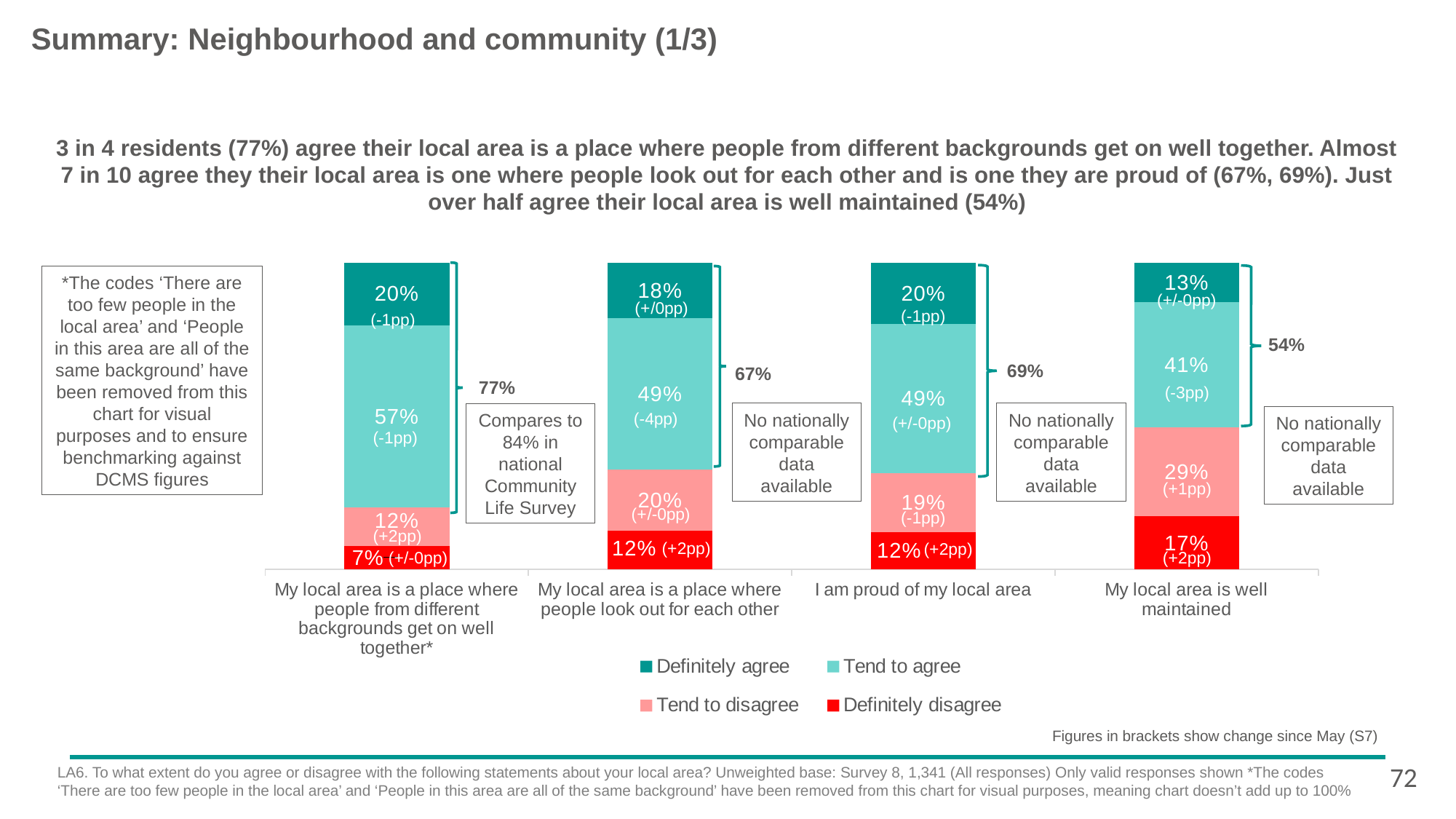
What is the 'Tend to agree' value for 'My local area is a place where people from different backgrounds get on well together*'? 57% What is the combined agree total (Definitely agree plus Tend to agree) shown for 'I am proud of my local area'? 69% What is the 'Definitely agree' value for 'My local area is a place where people look out for each other'? 18% Which statement has the lowest 'Definitely agree' value? My local area is well maintained Which is larger: the 'Definitely disagree' value for 'I am proud of my local area' or for 'My local area is well maintained'? My local area is well maintained What kind of chart is shown on the slide? Stacked bar chart What is the difference between the 'Tend to agree' values for 'My local area is a place where people from different backgrounds get on well together*' and 'My local area is well maintained'? 16 percentage points Which statement has the highest 'Tend to disagree' value? My local area is well maintained How many series does the legend list? 4 What is the 'Tend to disagree' value for 'I am proud of my local area'? 19% What is the 'Definitely disagree' value for 'My local area is well maintained'? 17% How many statements (categories) are shown on the x axis? 4